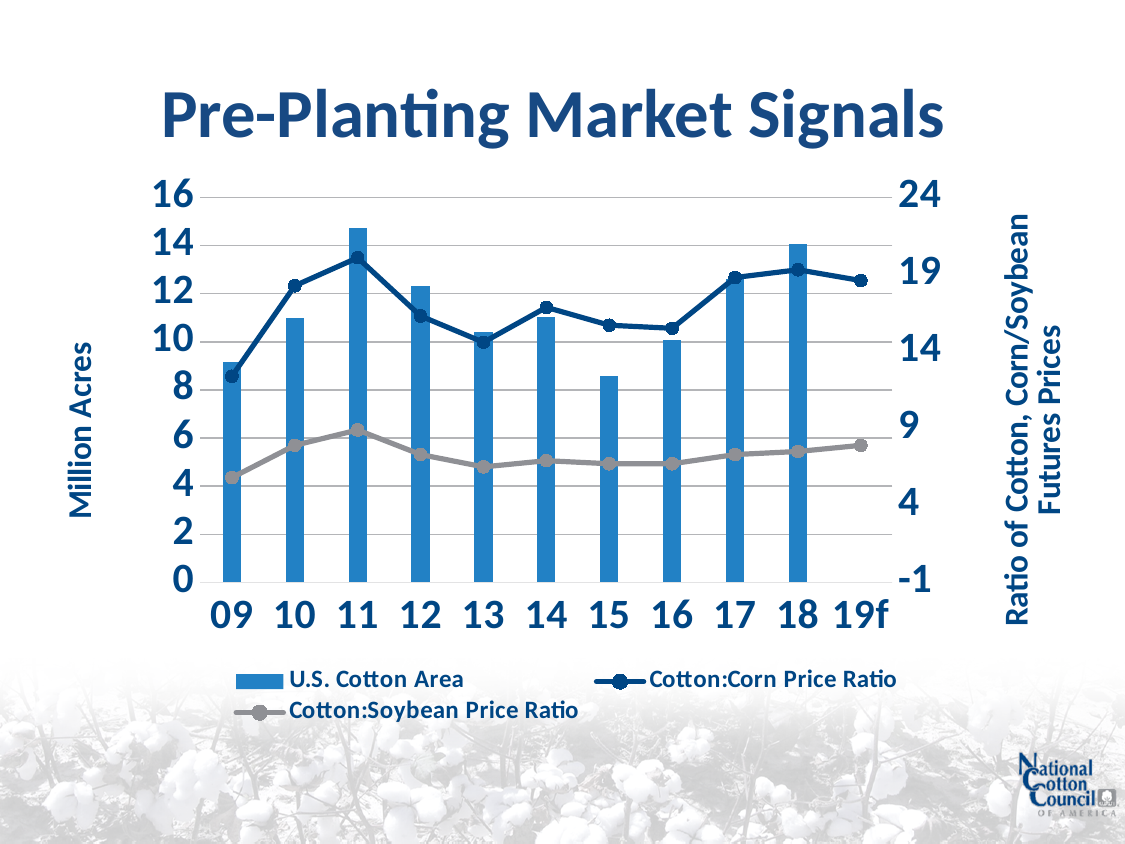
What is the title of the left vertical axis? Million Acres In which year is the Cotton:Corn Price Ratio at its lowest? 09 Is the U.S. Cotton Area value for 18 greater or less than 12 million acres? greater How many series does the legend list? 3 In which year does the Cotton:Soybean Price Ratio reach its highest point? 11 Which year has the larger U.S. Cotton Area, 11 or 12? 11 How many year categories are shown on the x axis? 11 What kind of chart is shown on the slide? Combination bar and line chart In which year is the U.S. Cotton Area bar the shortest? 15 In which year is the U.S. Cotton Area bar the tallest? 11 Is the U.S. Cotton Area value for 15 greater or less than 10 million acres? less Does the Cotton:Soybean Price Ratio rise or fall from 11 to 13? fall